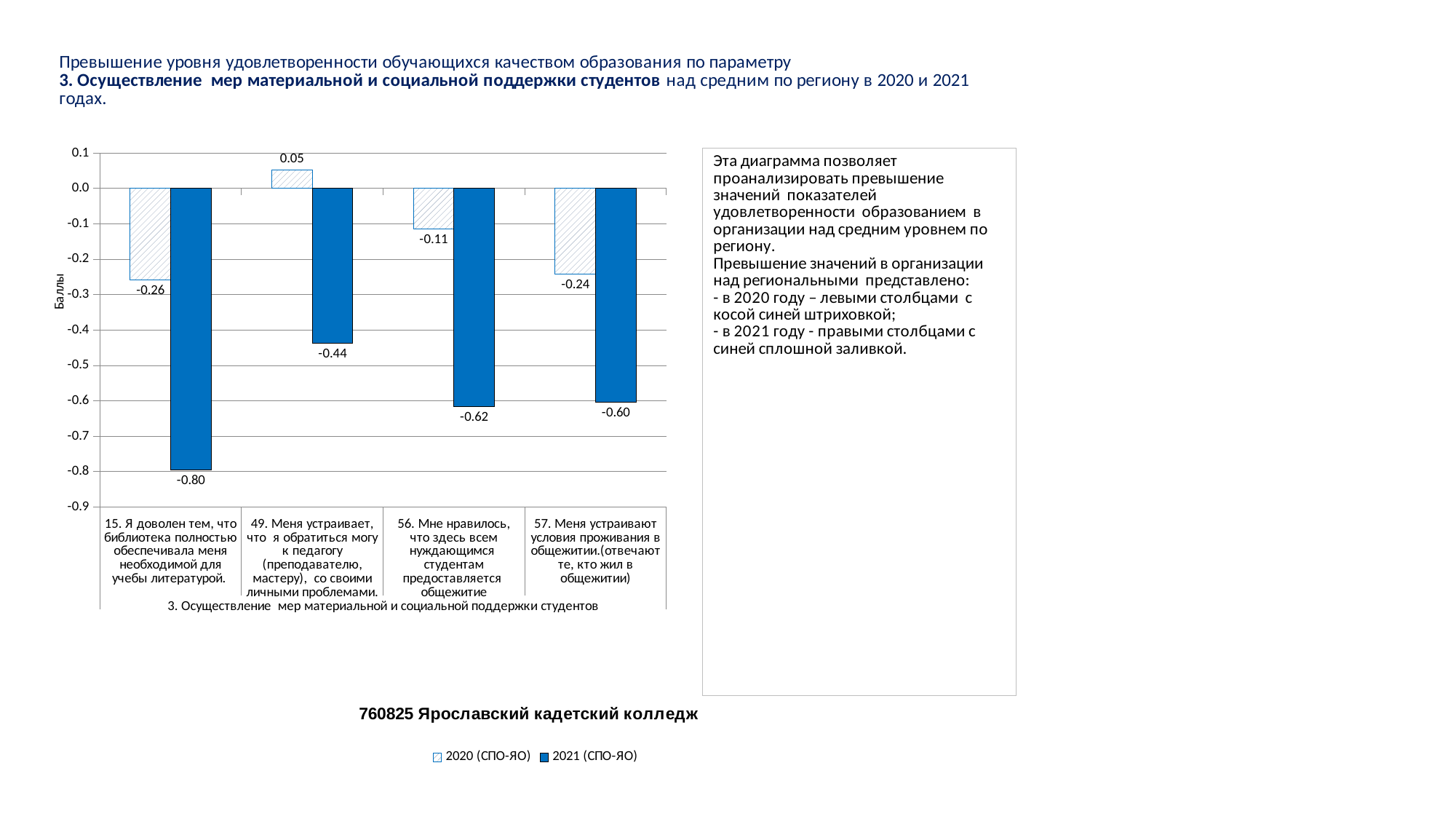
How many categories (questions) are shown on the x axis? 4 What is the difference between the 2020 and 2021 values for question 15 about the library? 0.54 Which category has the highest 2020 (СПО-ЯО) value? 49. Меня устраивает, что я обратиться могу к педагогу (преподавателю, мастеру), со своими личными проблемами. How many series does the legend list? 2 What is the 2020 (СПО-ЯО) value for question 49 about approaching a teacher with personal problems? 0.05 What is the 2021 (СПО-ЯО) value for question 15 about the library? -0.80 What is the 2020 (СПО-ЯО) value for question 57 about dormitory living conditions? -0.24 Which category has the lowest 2021 (СПО-ЯО) value? 15. Я доволен тем, что библиотека полностью обеспечивала меня необходимой для учебы литературой. What is the 2021 (СПО-ЯО) value for question 56 about dormitory provision? -0.62 What is the label of the y axis? Баллы For question 56, which is larger: the 2020 (СПО-ЯО) value or the 2021 (СПО-ЯО) value? 2020 (СПО-ЯО) What type of chart is shown on the slide? bar chart